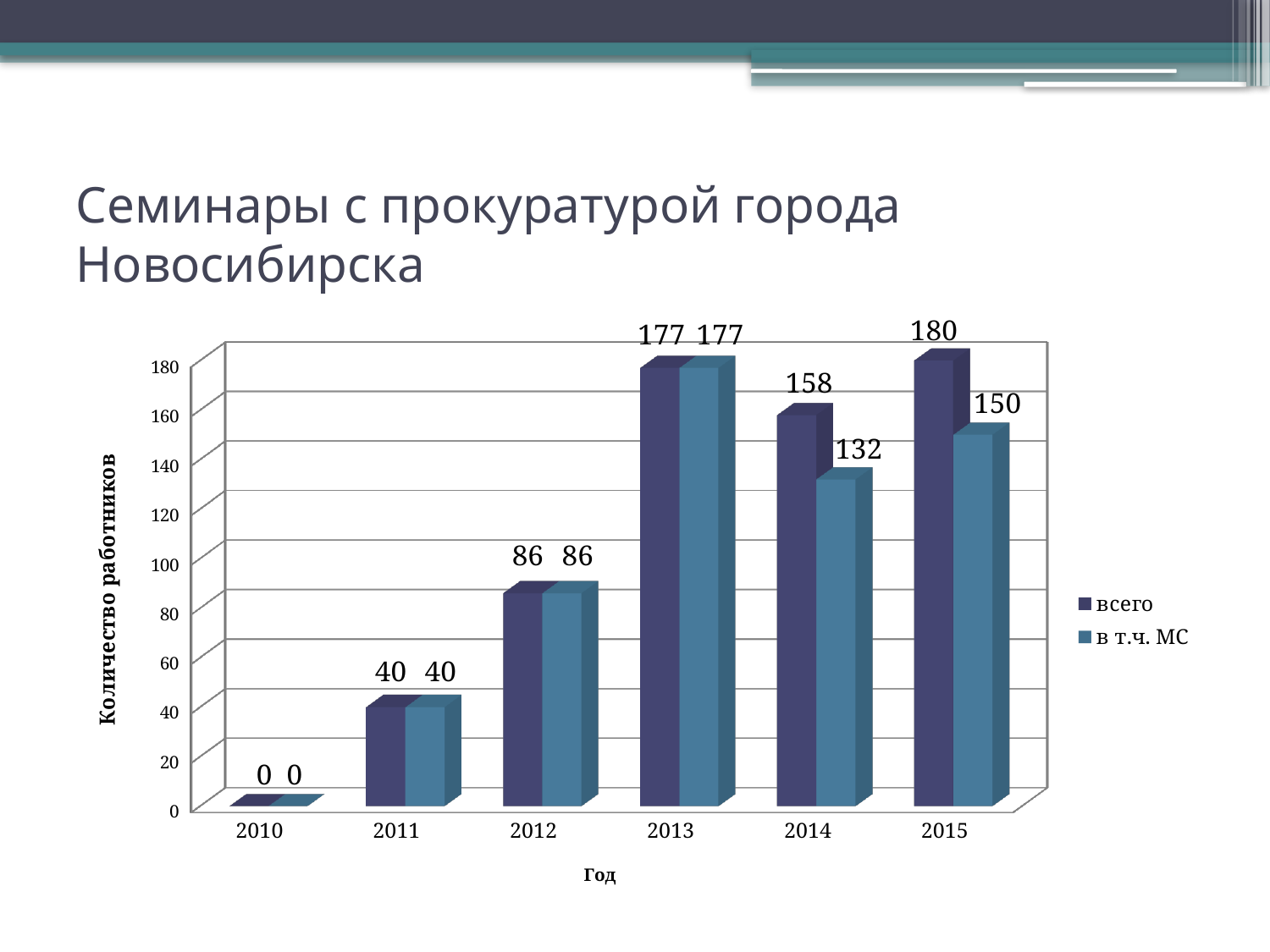
What is the value for "в т.ч. МС" in 2015? 150 What kind of chart is shown on the slide? bar chart What is the label of the vertical axis? Количество работников Which is larger: "в т.ч. МС" in 2013 or "в т.ч. МС" in 2015? 2013 Which year has the highest value for "всего"? 2015 What is the value for "всего" in 2014? 158 What is the difference between "всего" and "в т.ч. МС" in 2014? 26 What is the difference between the "всего" values for 2015 and 2013? 3 Which year has the lowest value for "в т.ч. МС"? 2010 How many series does the legend list? 2 What is the value for "всего" in 2012? 86 How many years are shown on the x axis? 6